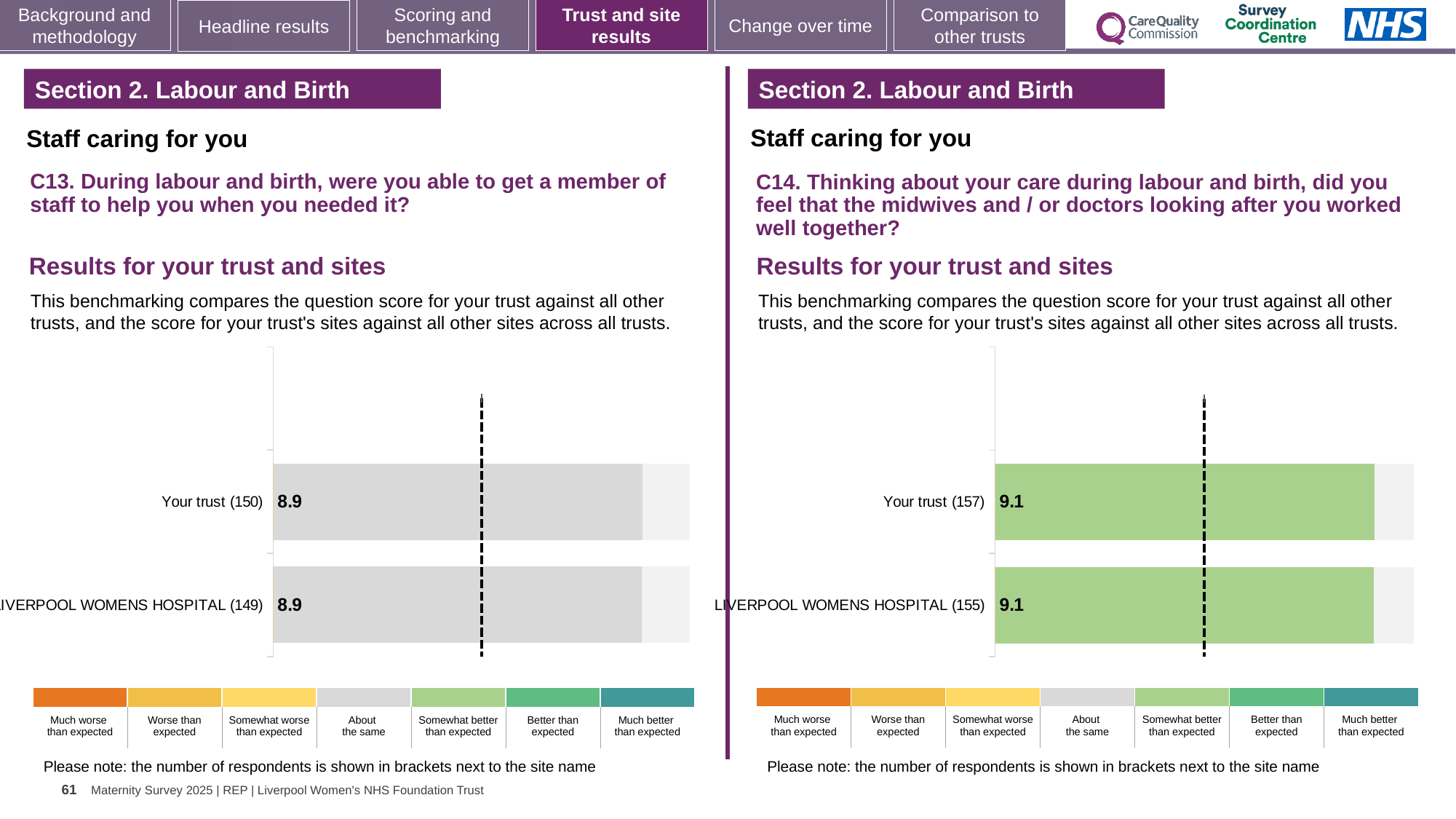
How many bars are plotted on the left chart (C13)? 2 On the left chart (C13), what is the difference between the Your trust score and the LIVERPOOL WOMENS HOSPITAL score? 0 On the left chart (C13), what is the score for LIVERPOOL WOMENS HOSPITAL? 8.9 On the right chart (C14), what is the score for Your trust? 9.1 On the right chart (C14), how many respondents are shown in brackets for LIVERPOOL WOMENS HOSPITAL? 155 On the left chart (C13), how many respondents are shown in brackets for Your trust? 150 How many bars are plotted on the right chart (C14)? 2 Is the Your trust score on the right chart (C14) larger or smaller than the Your trust score on the left chart (C13)? Larger On the left chart (C13), what is the score for Your trust? 8.9 On the right chart (C14), what is the score for LIVERPOOL WOMENS HOSPITAL? 9.1 On the right chart (C14), what is the difference between the Your trust score and the LIVERPOOL WOMENS HOSPITAL score? 0 What kind of chart is used on the left (C13)? Bar chart